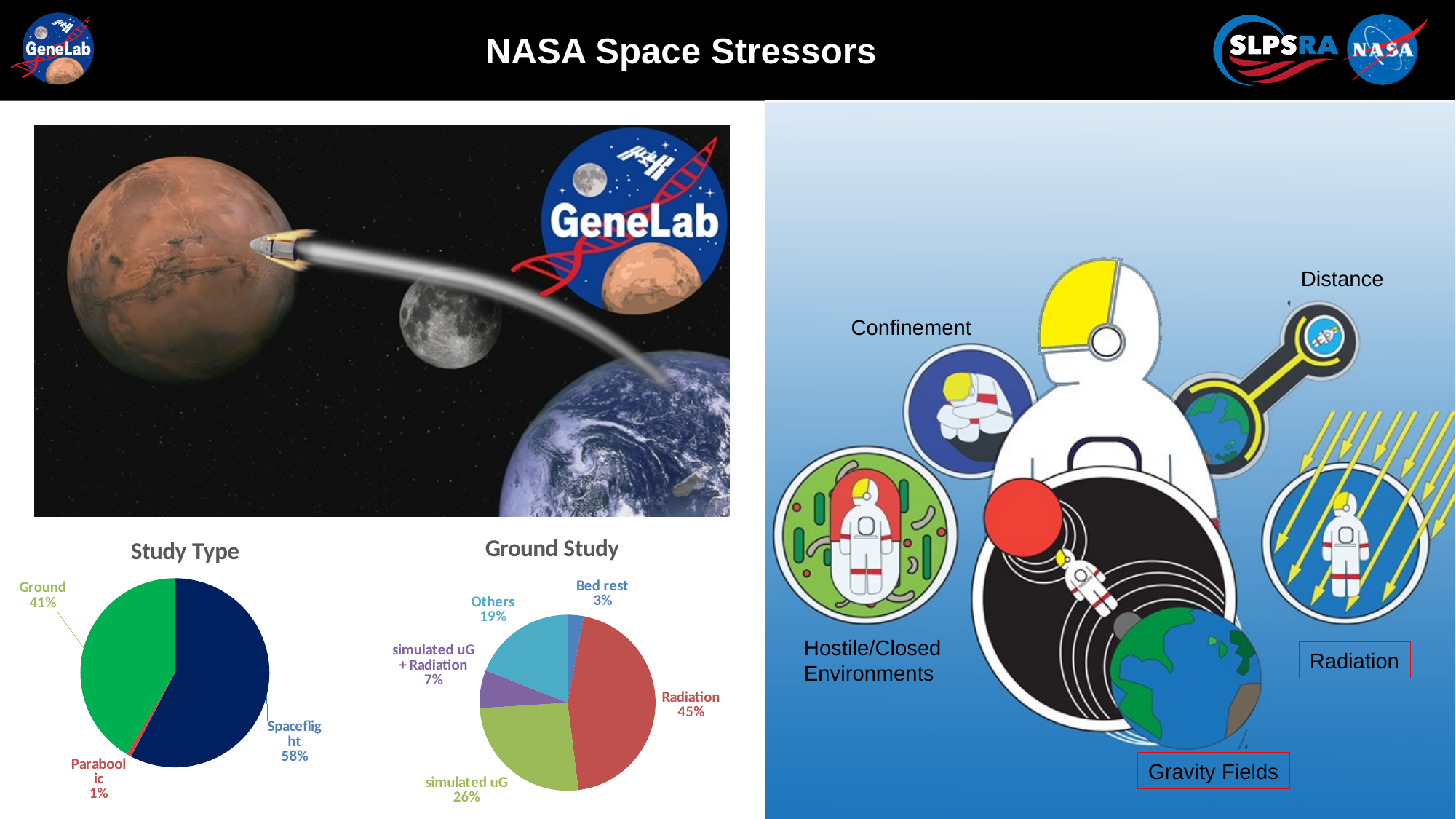
How many categories does the Ground Study chart show? 5 In the Ground Study chart, which is larger, Others or simulated uG + Radiation? Others How many categories does the Study Type chart show? 3 In the Study Type chart, what percentage is Ground? 41% In the Ground Study chart, what is the difference between Radiation and simulated uG? 19% What kind of chart is the Study Type chart? Pie chart In the Study Type chart, which category has the largest share? Spaceflight In the Study Type chart, what is the difference between the Spaceflight and Ground shares? 17% In the Study Type chart, what percentage is Spaceflight? 58% In the Ground Study chart, which category has the smallest share? Bed rest In the Ground Study chart, what percentage is Radiation? 45% In the Ground Study chart, what percentage is simulated uG? 26%